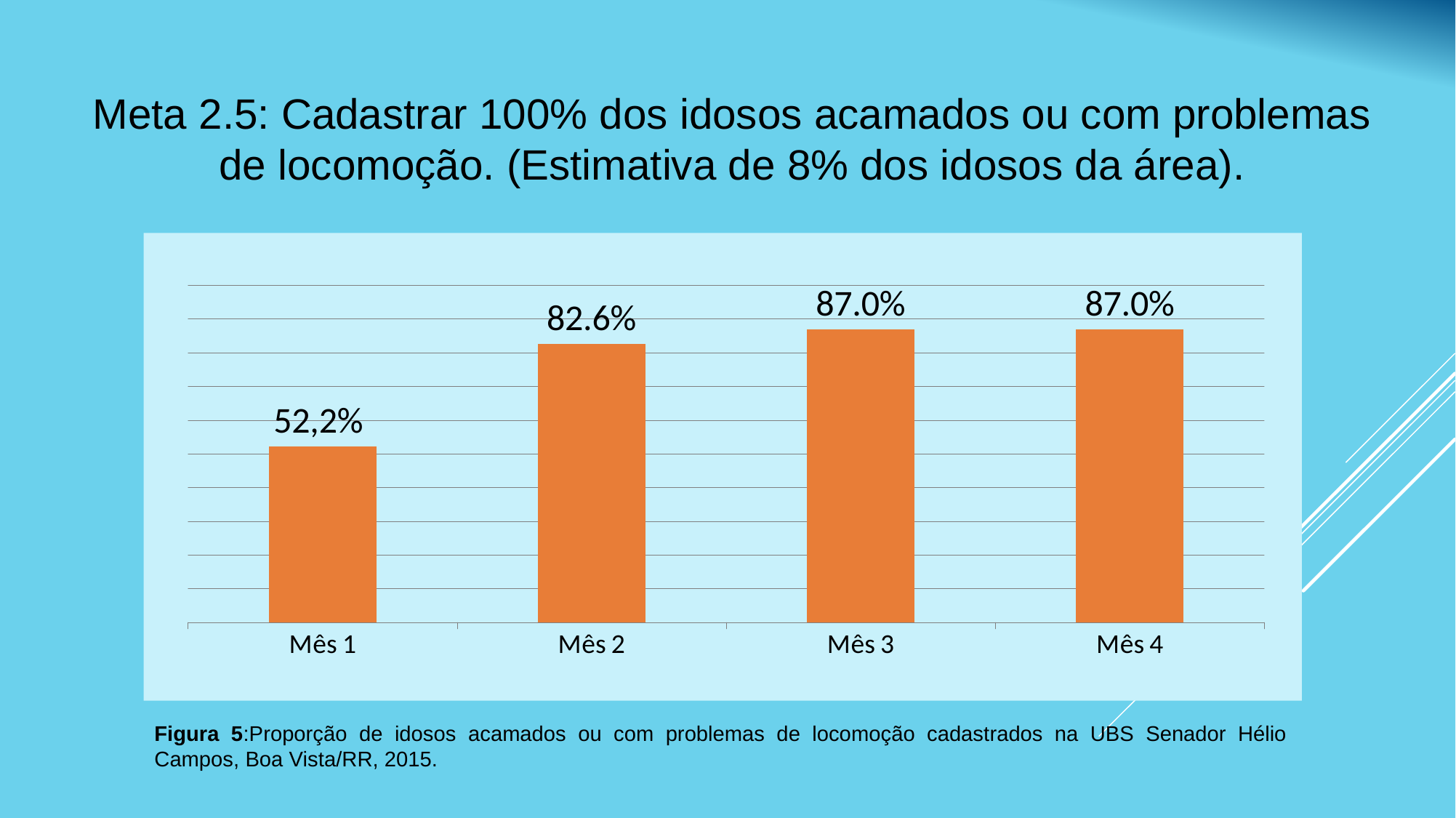
What is the value for Mês 2? 82.6% Which month has the lowest value? Mês 1 Which months share the highest value? Mês 3 and Mês 4 Which is larger, the value for Mês 1 or the value for Mês 2? Mês 2 What is the value for Mês 4? 87.0% What kind of chart is shown on the slide? Bar chart Do the values rise or fall from Mês 1 to Mês 3? Rise What is the value for Mês 1? 52,2% What is the value for Mês 3? 87.0% What is the difference in percentage points between Mês 2 and Mês 1? 30.4 How many months are shown on the x axis? 4 What is the difference in percentage points between Mês 3 and Mês 2? 4.4